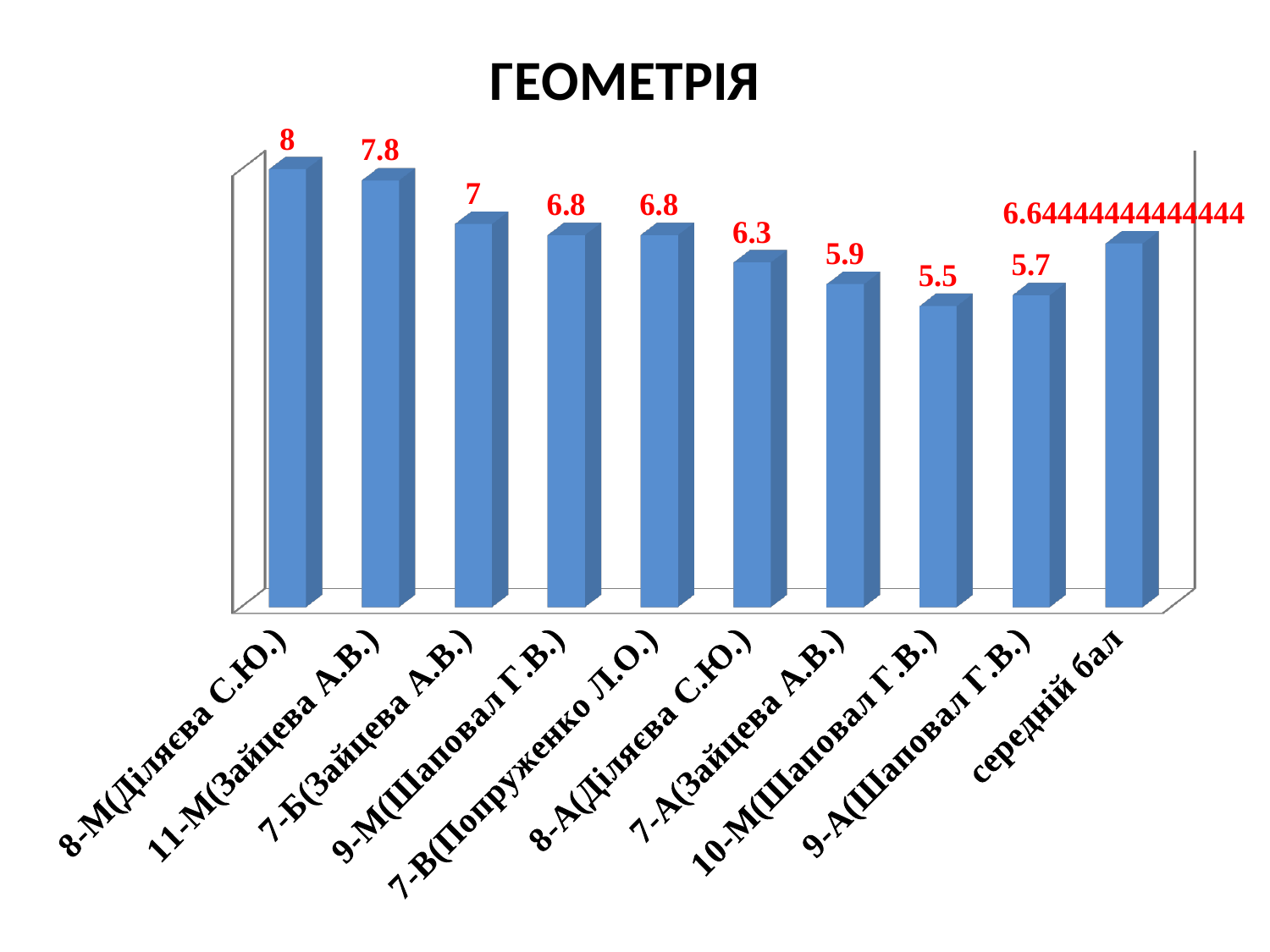
What is the difference between the values for 8-М(Діляєва С.Ю.) and 7-Б(Зайцева А.В.)? 1 What is the difference between the values for 9-А(Шаповал Г.В.) and 10-М(Шаповал Г.В.)? 0.2 What is the value for 11-М(Зайцева А.В.)? 7.8 How many categories are shown on the chart? 10 What is the title of the chart? ГЕОМЕТРІЯ Which category has the highest value? 8-М(Діляєва С.Ю.) What is the value shown for середній бал? 6.64444444444444 What kind of chart is shown on the slide? Bar chart Which is larger, the value for 8-А(Діляєва С.Ю.) or the value for 7-А(Зайцева А.В.)? 8-А(Діляєва С.Ю.) What is the value for 10-М(Шаповал Г.В.)? 5.5 Which category has the lowest value? 10-М(Шаповал Г.В.) What is the value for 8-М(Діляєва С.Ю.)? 8